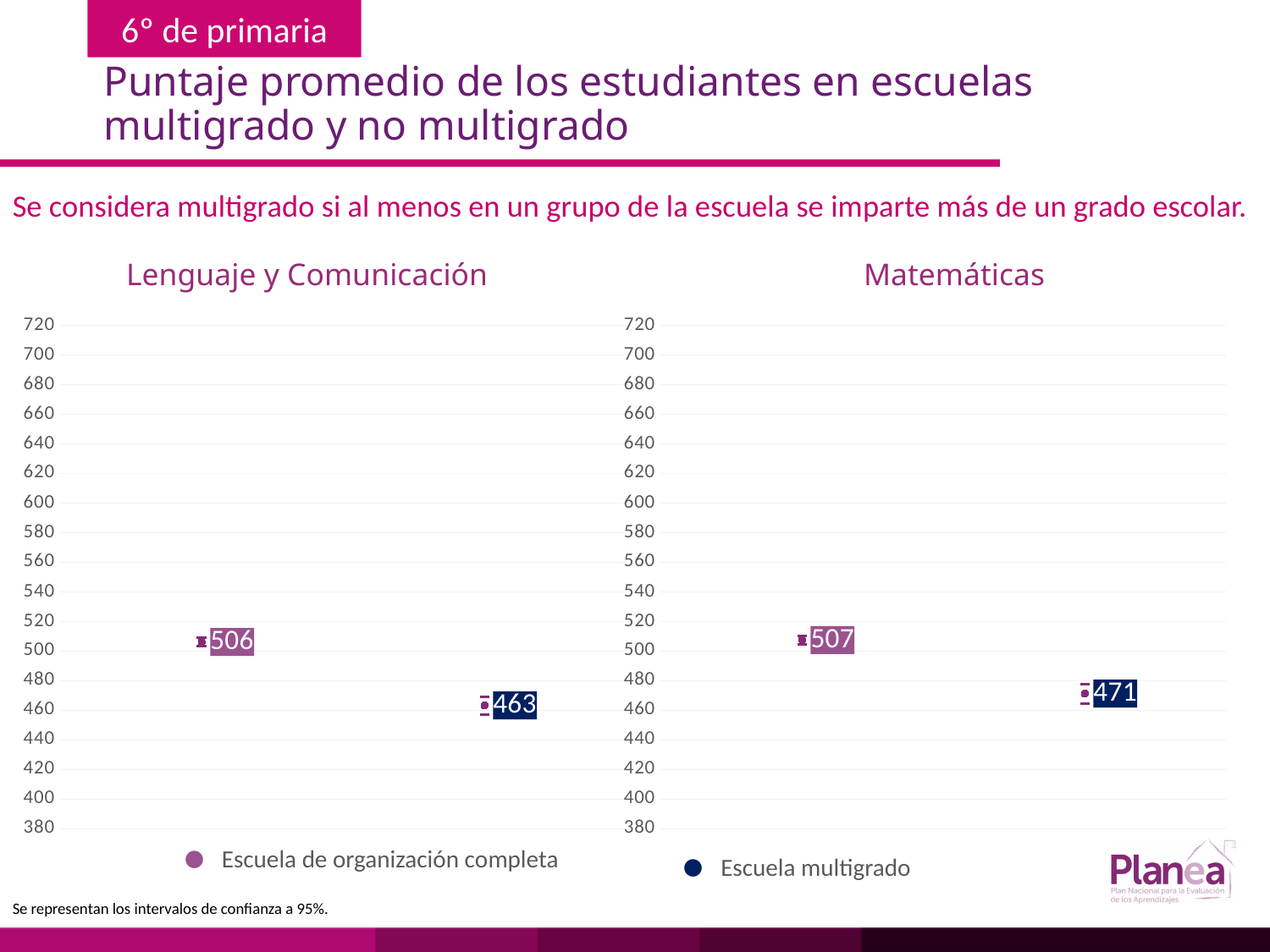
In the Lenguaje y Comunicación chart, what is the value for Escuela de organización completa? 506 How many data points are plotted in the Lenguaje y Comunicación chart? 2 In the Lenguaje y Comunicación chart, what is the value for Escuela multigrado? 463 What colour is used for the Escuela multigrado series? Dark blue In the Lenguaje y Comunicación chart, which series has the lowest value? Escuela multigrado How many series does the legend list? 2 In the Matemáticas chart, what is the value for Escuela multigrado? 471 In the Matemáticas chart, which has the higher value, Escuela de organización completa or Escuela multigrado? Escuela de organización completa In the Matemáticas chart, what is the difference between the values for Escuela de organización completa and Escuela multigrado? 36 In the Matemáticas chart, what is the value for Escuela de organización completa? 507 In the Matemáticas chart, is the value for Escuela multigrado greater or less than 500? less In the Lenguaje y Comunicación chart, what is the difference between the values for Escuela de organización completa and Escuela multigrado? 43